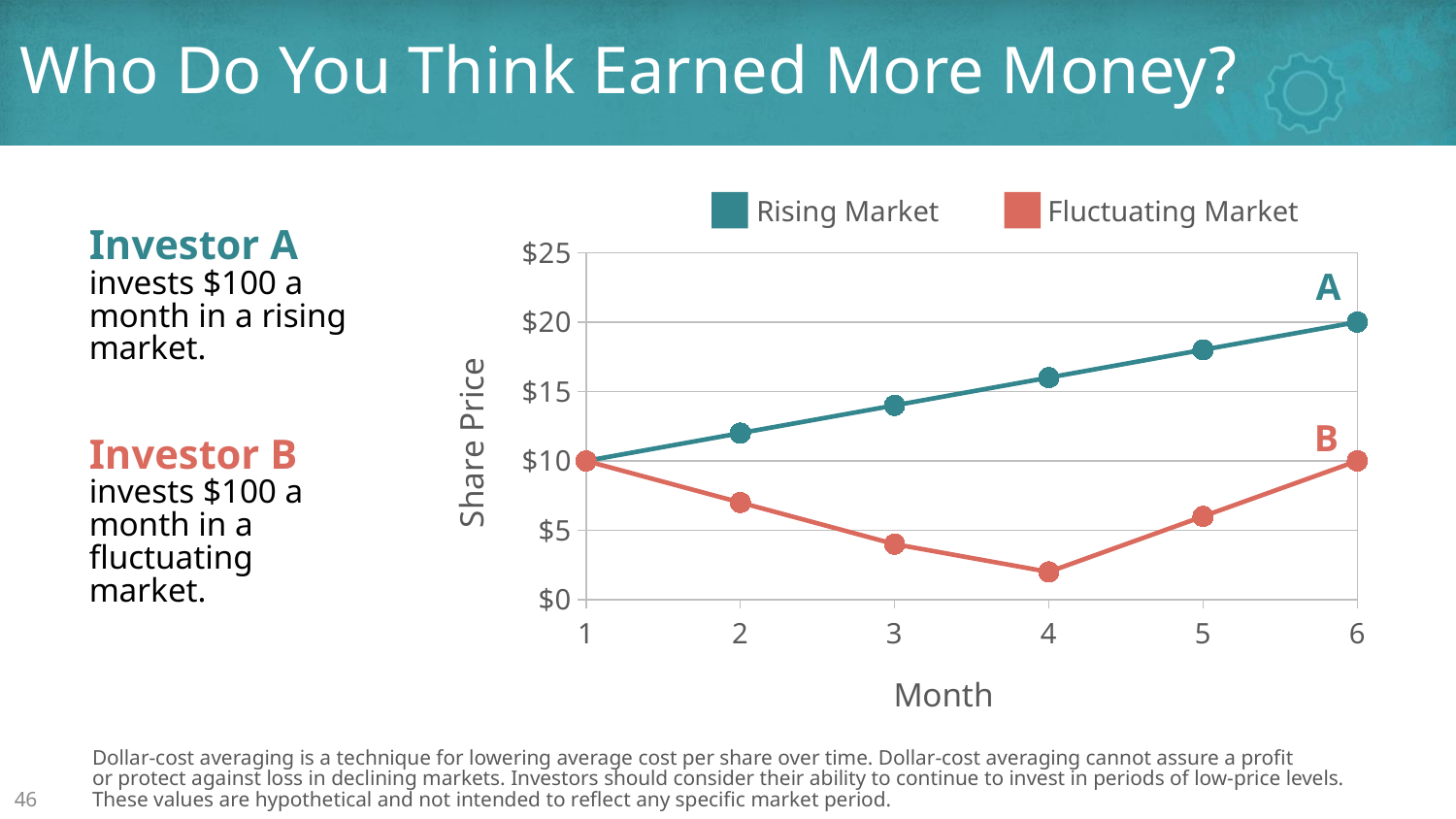
What is the share price for the Fluctuating Market in month 6? $10 In which month is the Fluctuating Market share price lowest? 4 How many months are plotted along the x axis? 6 Is the Fluctuating Market share price in month 4 greater or less than $5? less What kind of chart is shown on the slide? line chart Does the Rising Market share price rise or fall from month 1 to month 6? rise In month 3, which series has the higher share price, Rising Market or Fluctuating Market? Rising Market How many series does the legend list? 2 What is the share price for the Rising Market in month 6? $20 What is the share price for the Rising Market in month 1? $10 Is the Rising Market share price in month 4 greater or less than $15? greater What is the difference between the Rising Market and Fluctuating Market share prices in month 6? $10